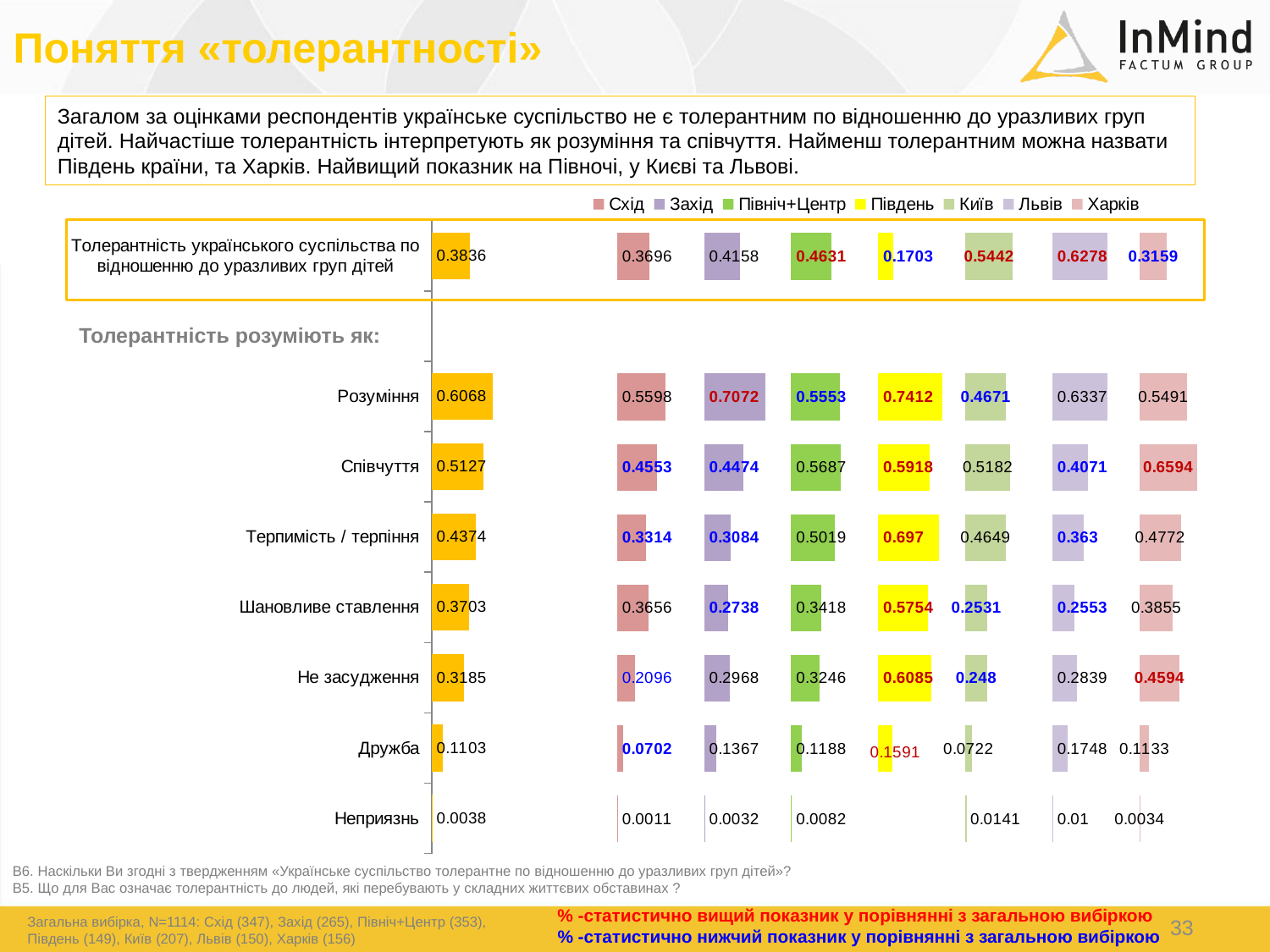
What is the difference between the Львів and Схід values for "Толерантність українського суспільства по відношенню до уразливих груп дітей"? 0.2582 What value is shown for Харків for "Співчуття"? 0.6594 How many regions are listed in the legend? 7 What type of chart is used on this slide? Bar chart Which region has the highest value for "Терпимість / терпіння"? Південь What value is shown for Львів for "Толерантність українського суспільства по відношенню до уразливих груп дітей"? 0.6278 Which region has the highest value for "Не засудження"? Південь What value is shown for Південь for "Розуміння"? 0.7412 Which region has the lowest value for "Толерантність українського суспільства по відношенню до уразливих груп дітей"? Південь Which is larger for "Шановливе ставлення": the value for Схід or the value for Захід? Схід How many interpretations of tolerance are listed under "Толерантність розуміють як:"? 7 Which colour represents Південь in the legend? Yellow